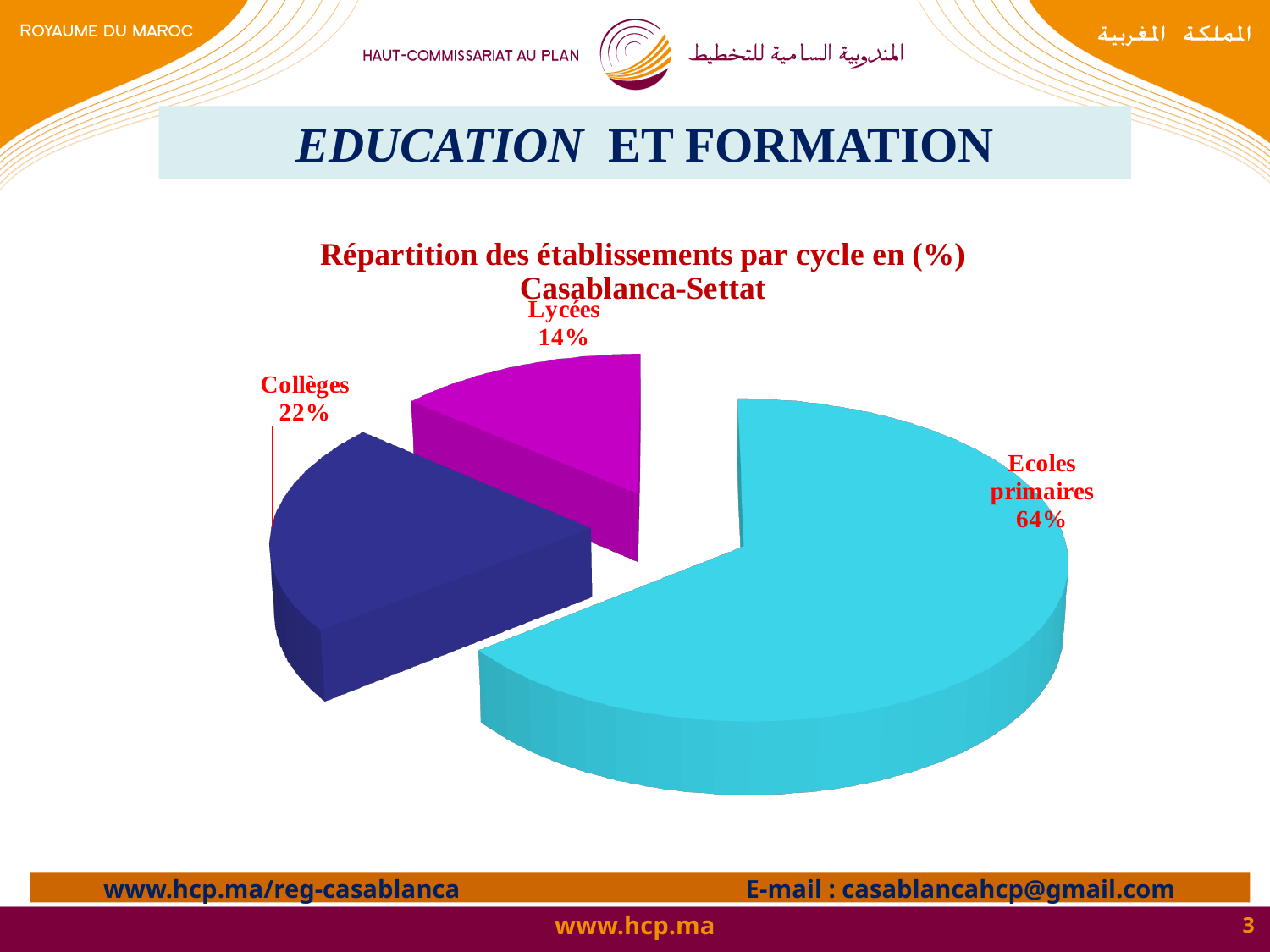
How many cycles (slices) are shown in the pie chart? 3 What is the difference in percentage points between Ecoles primaires and Collèges? 42 Which has a larger share, Collèges or Lycées? Collèges What percentage of establishments are Lycées? 14% What is the title of the chart? Répartition des établissements par cycle en (%) Casablanca-Settat What kind of chart is shown on the slide? Pie chart What is the difference in percentage points between Collèges and Lycées? 8 What percentage of establishments are Collèges? 22% What colour is the Ecoles primaires slice? Cyan (light blue) Which cycle has the largest share of establishments? Ecoles primaires What percentage of establishments are Ecoles primaires? 64% Which cycle has the smallest share of establishments? Lycées